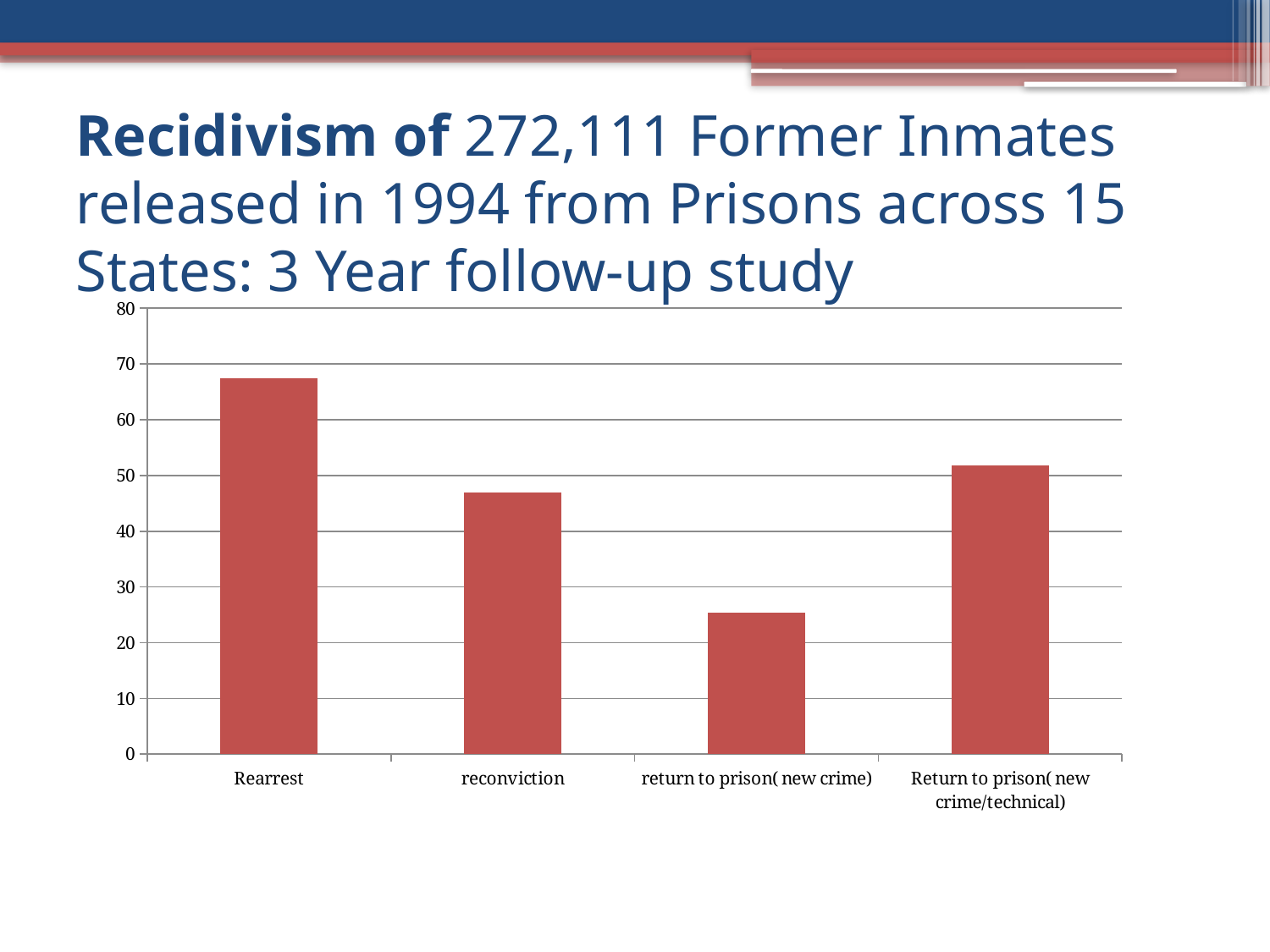
Which is larger, the value for reconviction or the value for Return to prison( new crime/technical)? Return to prison( new crime/technical) Is the value for Rearrest greater or less than 60? greater Is the value for return to prison( new crime) greater or less than 30? less Is the value for reconviction greater or less than 50? less How many categories are shown on the x axis of the chart? 4 Which is larger, the value for Rearrest or the value for return to prison( new crime)? Rearrest Which category has the lowest bar in the chart? return to prison( new crime) What kind of chart is shown on the slide? bar chart What is the highest value shown on the y axis of the chart? 80 Which category has the highest bar in the chart? Rearrest